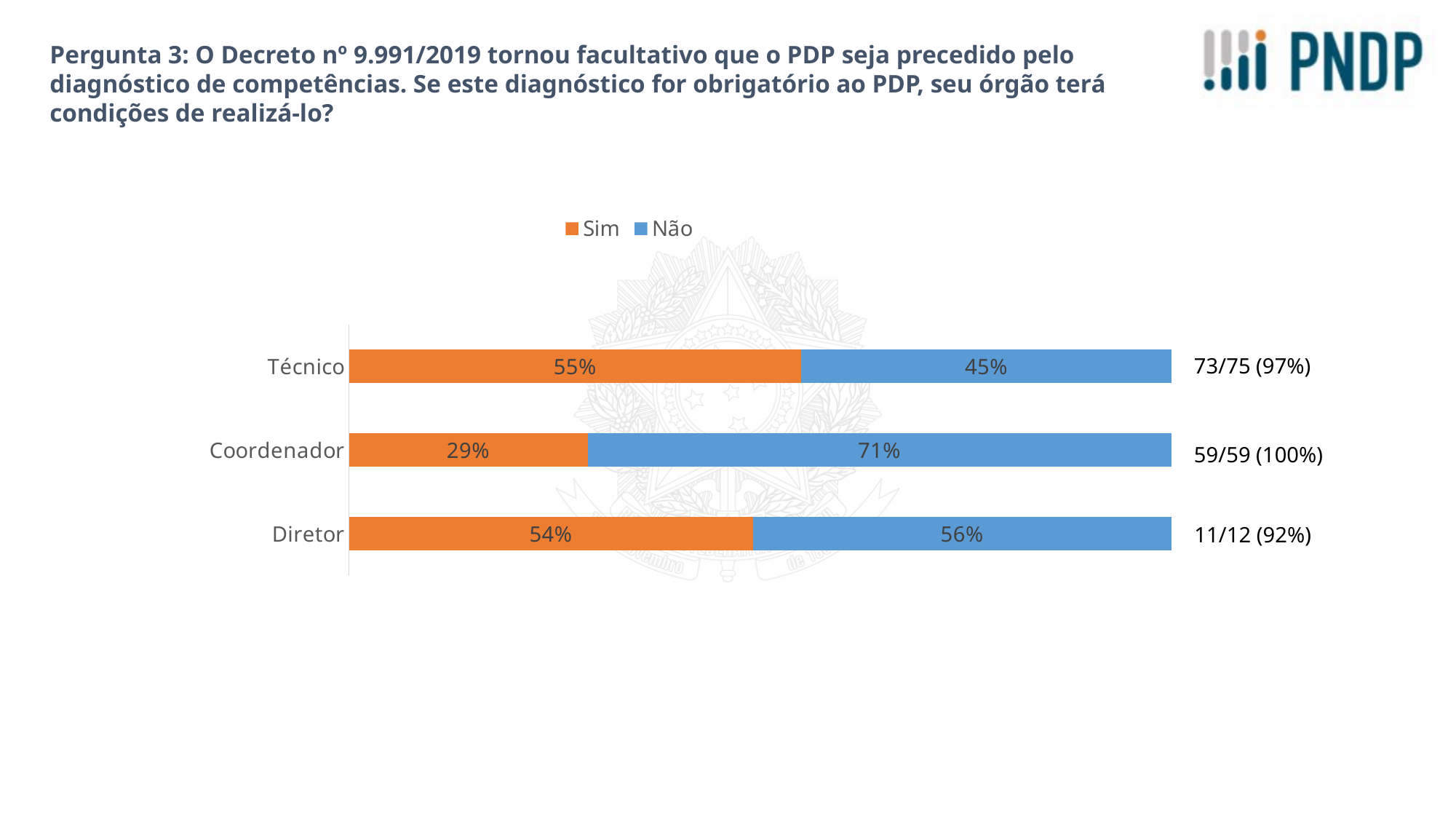
How many categories are shown on the chart? 3 What percentage of Técnico respondents answered Sim? 55% Which category has the highest Não percentage? Coordenador What percentage of Coordenador respondents answered Não? 71% Which category has the lowest Sim percentage? Coordenador What is the Não value for the Técnico category? 45% What response count and rate is shown next to the Coordenador bar? 59/59 (100%) What kind of chart is shown on the slide? Stacked horizontal bar chart For Técnico, is the Sim share or the Não share larger? Sim What percentage of Diretor respondents answered Sim? 54% How many series does the legend list? 2 For Coordenador, how many percentage points higher is Não than Sim? 42 percentage points